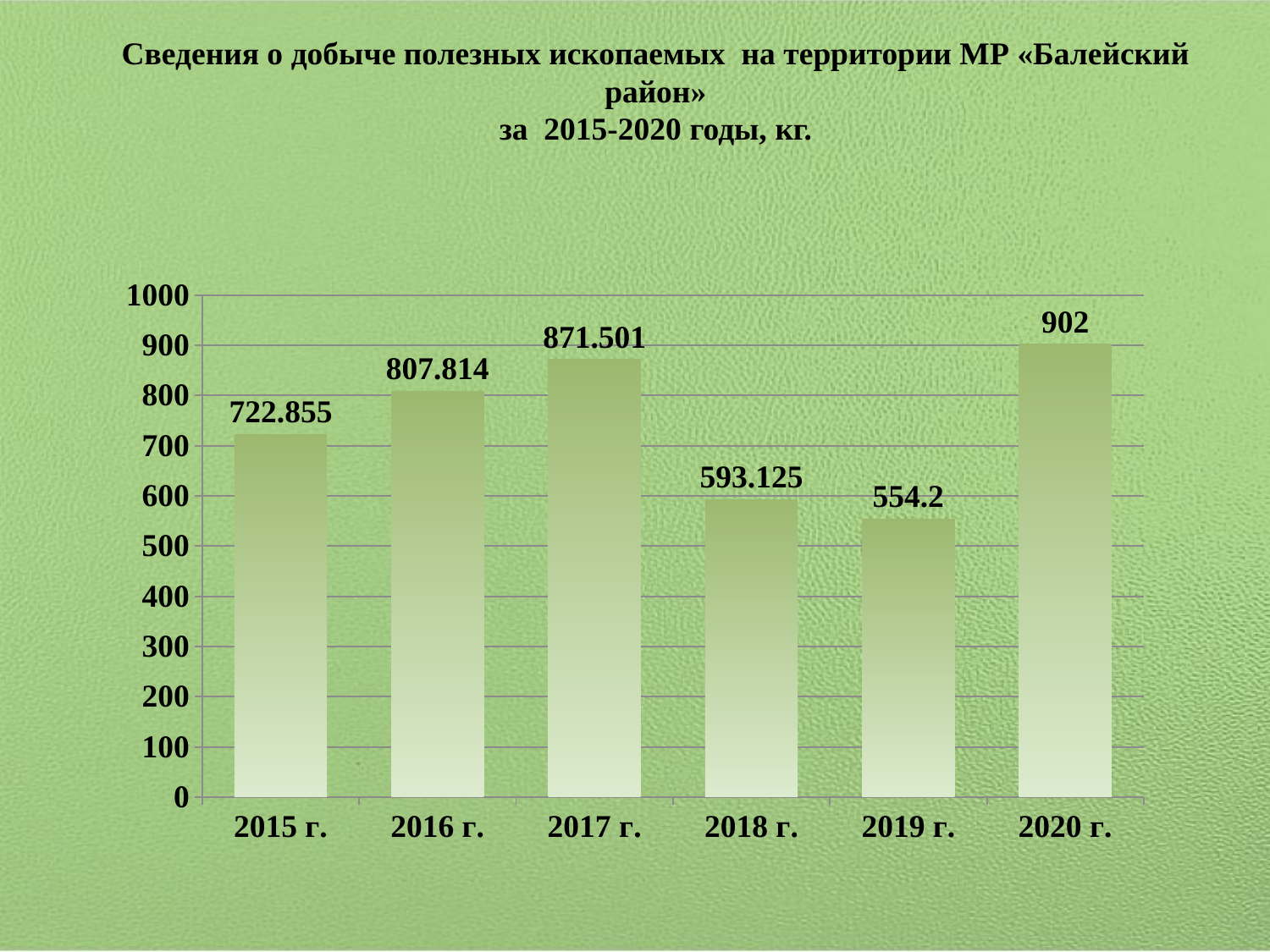
What is the value for 2018 г.? 593.125 What is the difference between the values for 2020 г. and 2019 г.? 347.8 What is the difference between the values for 2017 г. and 2016 г.? 63.687 How many years are shown on the x axis? 6 Do the values rise or fall from 2017 г. to 2019 г.? fall Which is larger, the value for 2016 г. or the value for 2018 г.? 2016 г. Is the value for 2019 г. greater or less than 600? less What is the value for 2015 г.? 722.855 Which year has the highest value? 2020 г. What kind of chart is shown on the slide? bar chart What is the value for 2020 г.? 902 Which year has the lowest value? 2019 г.